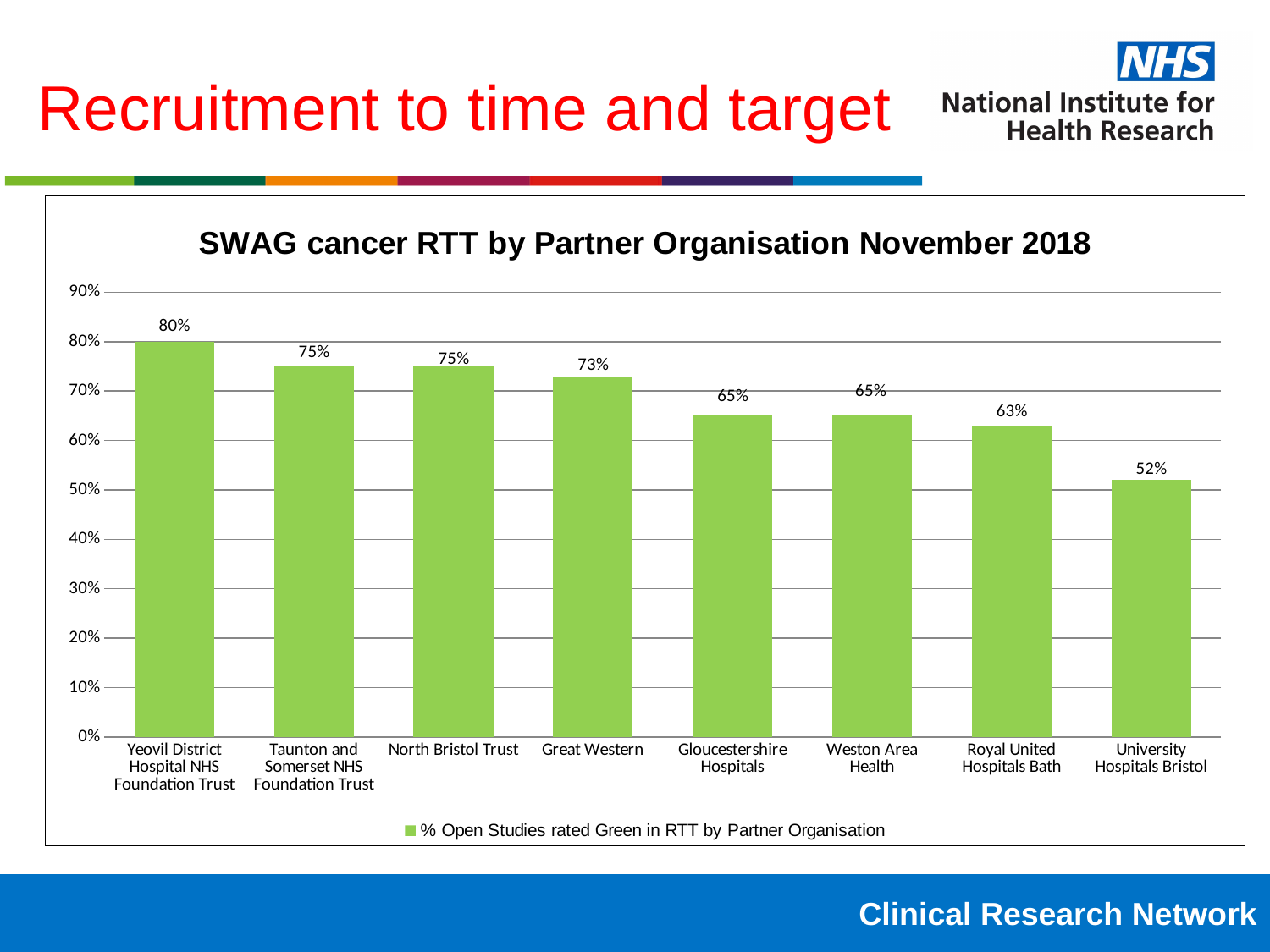
Which partner organisation has the lowest value? University Hospitals Bristol How many partner organisations are shown on the chart? 8 What is the difference between the values for Great Western and Gloucestershire Hospitals? 8% What is the value for Yeovil District Hospital NHS Foundation Trust? 80% What is the title of the chart? SWAG cancer RTT by Partner Organisation November 2018 What kind of chart is shown on the slide? Bar chart What is the value for Great Western? 73% Which is larger, the value for North Bristol Trust or the value for Weston Area Health? North Bristol Trust What is the difference between the values for Yeovil District Hospital NHS Foundation Trust and University Hospitals Bristol? 28% Which partner organisation has the highest value? Yeovil District Hospital NHS Foundation Trust What is the value for Royal United Hospitals Bath? 63% Is the value for University Hospitals Bristol greater or less than 60%? less